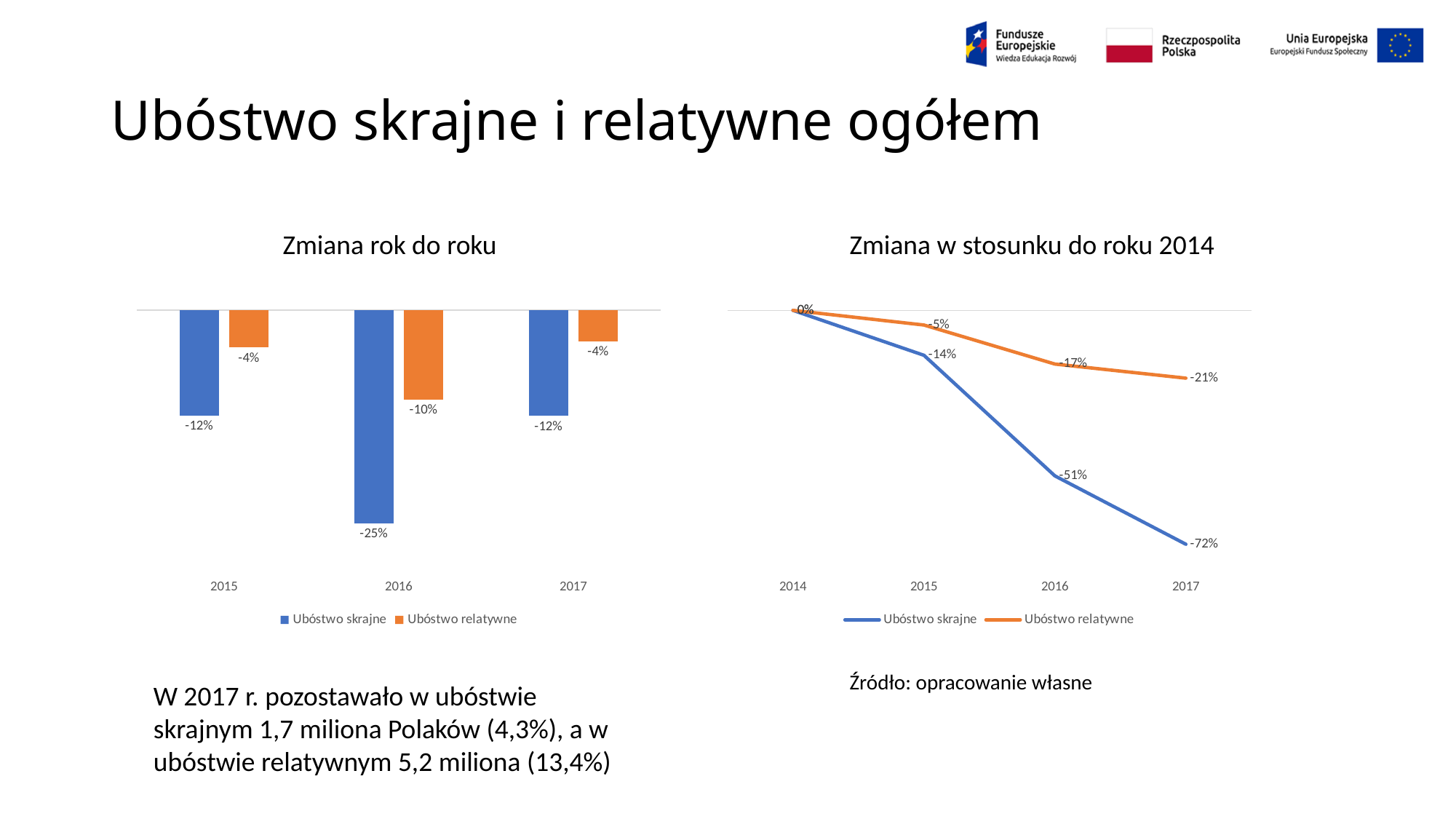
In the chart 'Zmiana rok do roku', what is the difference between the Ubóstwo skrajne and Ubóstwo relatywne values in 2015? 8 percentage points In the chart 'Zmiana w stosunku do roku 2014', which series has the lower value in 2017, Ubóstwo skrajne or Ubóstwo relatywne? Ubóstwo skrajne How many series does the legend of the chart 'Zmiana w stosunku do roku 2014' list? 2 In the chart 'Zmiana w stosunku do roku 2014', do the values for Ubóstwo skrajne rise or fall from 2014 to 2017? Fall In the chart 'Zmiana rok do roku', what is the value for Ubóstwo relatywne in 2016? -10% In the chart 'Zmiana rok do roku', in which year does Ubóstwo skrajne have its lowest value? 2016 In the chart 'Zmiana w stosunku do roku 2014', what is the value for Ubóstwo skrajne in 2017? -72% In the chart 'Zmiana rok do roku', how many years are shown on the x axis? 3 In the chart 'Zmiana w stosunku do roku 2014', what is the value for Ubóstwo relatywne in 2016? -17% In the chart 'Zmiana rok do roku', what is the value for Ubóstwo skrajne in 2016? -25% What kind of chart is 'Zmiana rok do roku'? Bar chart What kind of chart is 'Zmiana w stosunku do roku 2014'? Line chart